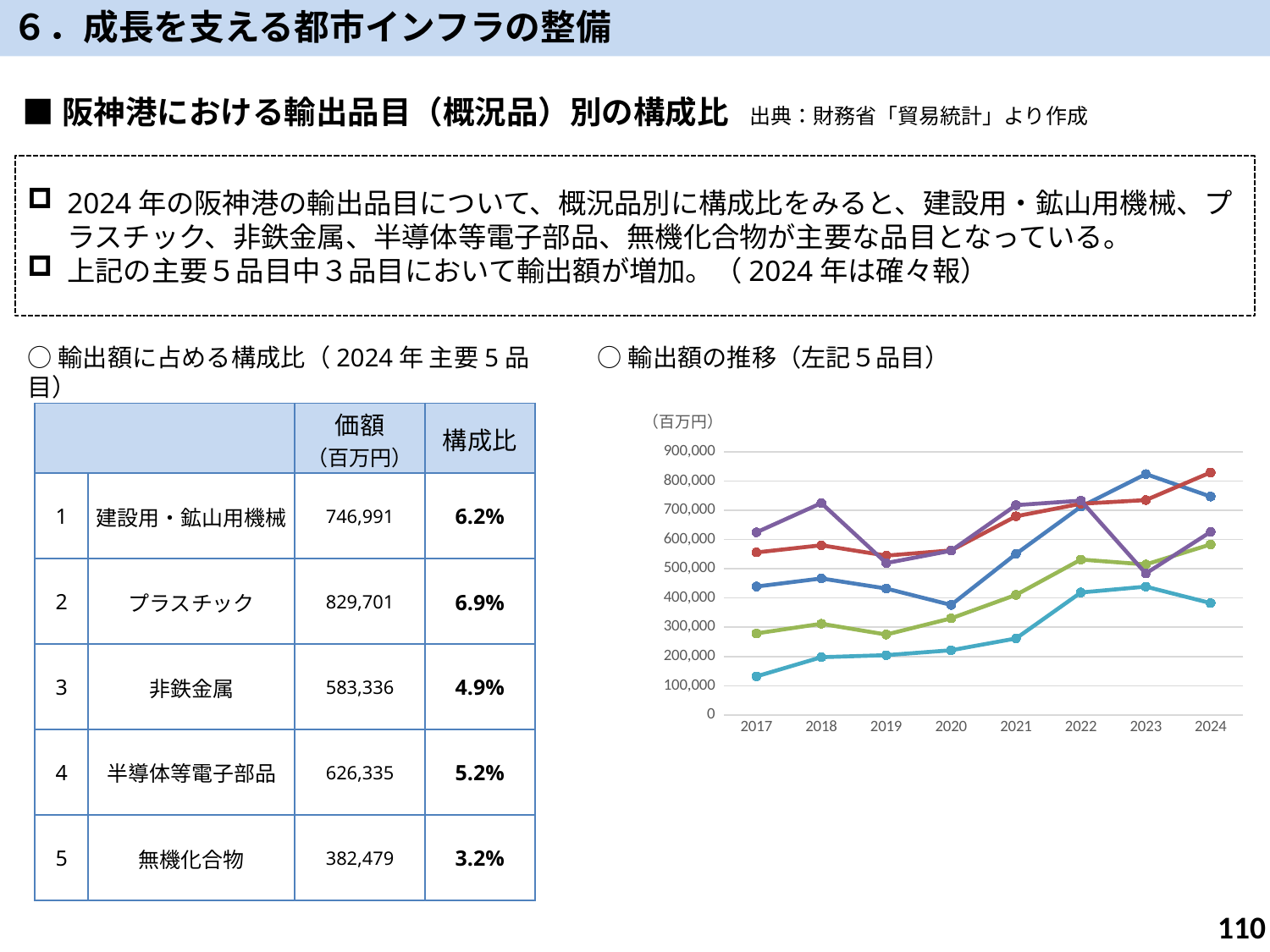
In the 輸出額の推移 line chart, is the value of the green line in 2017 greater or less than 300,000? less What unit is shown above the y axis of the 輸出額の推移 line chart? 百万円 In the 輸出額の推移 line chart, does the light blue (teal) line generally rise or fall from 2017 to 2023? rise How many years are plotted along the x axis of the 輸出額の推移 line chart? 8 In the 輸出額の推移 line chart, is the value of the light blue (teal) line in 2017 greater or less than 200,000? less In the 輸出額の推移 line chart, is the value of the purple line in 2018 greater or less than 700,000? greater In the 輸出額の推移 line chart, which is higher in 2024, the red line or the dark blue line? the red line What is the first year shown on the x axis of the 輸出額の推移 line chart? 2017 What kind of chart is the 輸出額の推移（左記５品目） chart on the right of the slide? line chart In the 輸出額の推移 line chart, which line has the lowest value in 2017? the light blue (teal) line